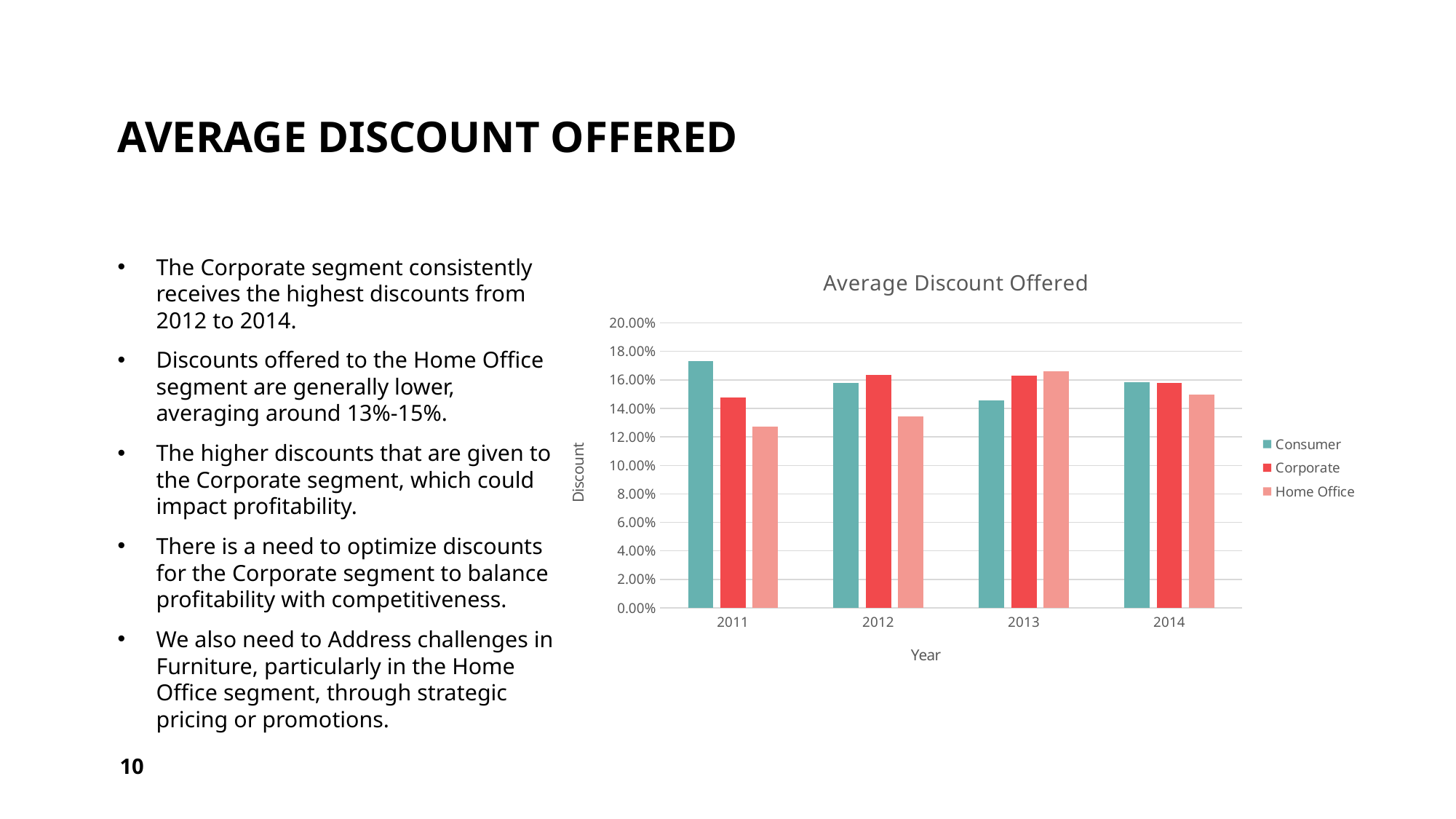
What is the label on the vertical axis of the chart? Discount How many series does the legend of the Average Discount Offered chart list? 3 Is the Home Office discount in 2011 greater or less than 14.00%? less In which year is the Consumer discount highest? 2011 Is the Consumer discount in 2011 greater or less than 16.00%? greater What kind of chart is shown on the slide? bar chart In 2011, which segment received the larger discount, Consumer or Corporate? Consumer Does the Home Office discount rise or fall from 2011 to 2013? rise Is the Corporate discount in 2013 greater or less than 14.00%? greater In which year is the Home Office discount lowest? 2011 How many years are shown on the x axis of the Average Discount Offered chart? 4 In 2012, which segment received the larger discount, Corporate or Home Office? Corporate